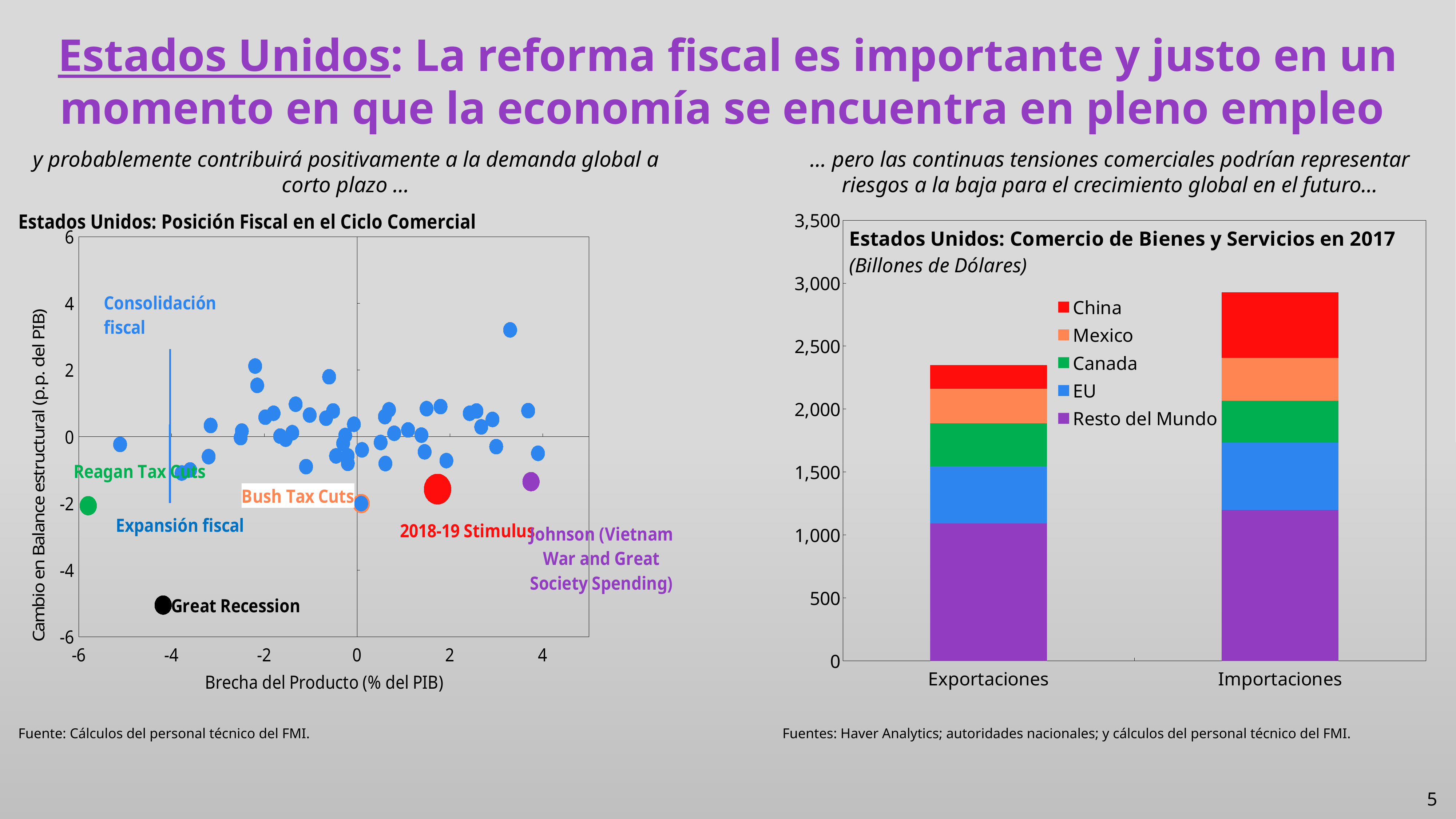
In the chart 'Estados Unidos: Comercio de Bienes y Servicios en 2017', which bar is taller, Exportaciones or Importaciones? Importaciones In the chart 'Estados Unidos: Comercio de Bienes y Servicios en 2017', is the total for Exportaciones greater or less than 2,500? less What kind of chart is the chart titled 'Estados Unidos: Comercio de Bienes y Servicios en 2017'? Stacked bar chart In the chart 'Estados Unidos: Posición Fiscal en el Ciclo Comercial', is the vertical-axis value for the Great Recession point greater or less than -4? less In the chart 'Estados Unidos: Posición Fiscal en el Ciclo Comercial', which labeled point has the lowest value on the vertical axis? Great Recession What kind of chart is the chart titled 'Estados Unidos: Posición Fiscal en el Ciclo Comercial'? Scatter chart In the chart 'Estados Unidos: Comercio de Bienes y Servicios en 2017', how many series does the legend list? 5 In the chart 'Estados Unidos: Comercio de Bienes y Servicios en 2017', is the total for Importaciones greater or less than 2,500? greater In the chart 'Estados Unidos: Comercio de Bienes y Servicios en 2017', how many categories are shown on the x axis? 2 In the chart 'Estados Unidos: Comercio de Bienes y Servicios en 2017', which legend entry is shown in purple? Resto del Mundo In the chart 'Estados Unidos: Posición Fiscal en el Ciclo Comercial', what is the label of the horizontal axis? Brecha del Producto (% del PIB)